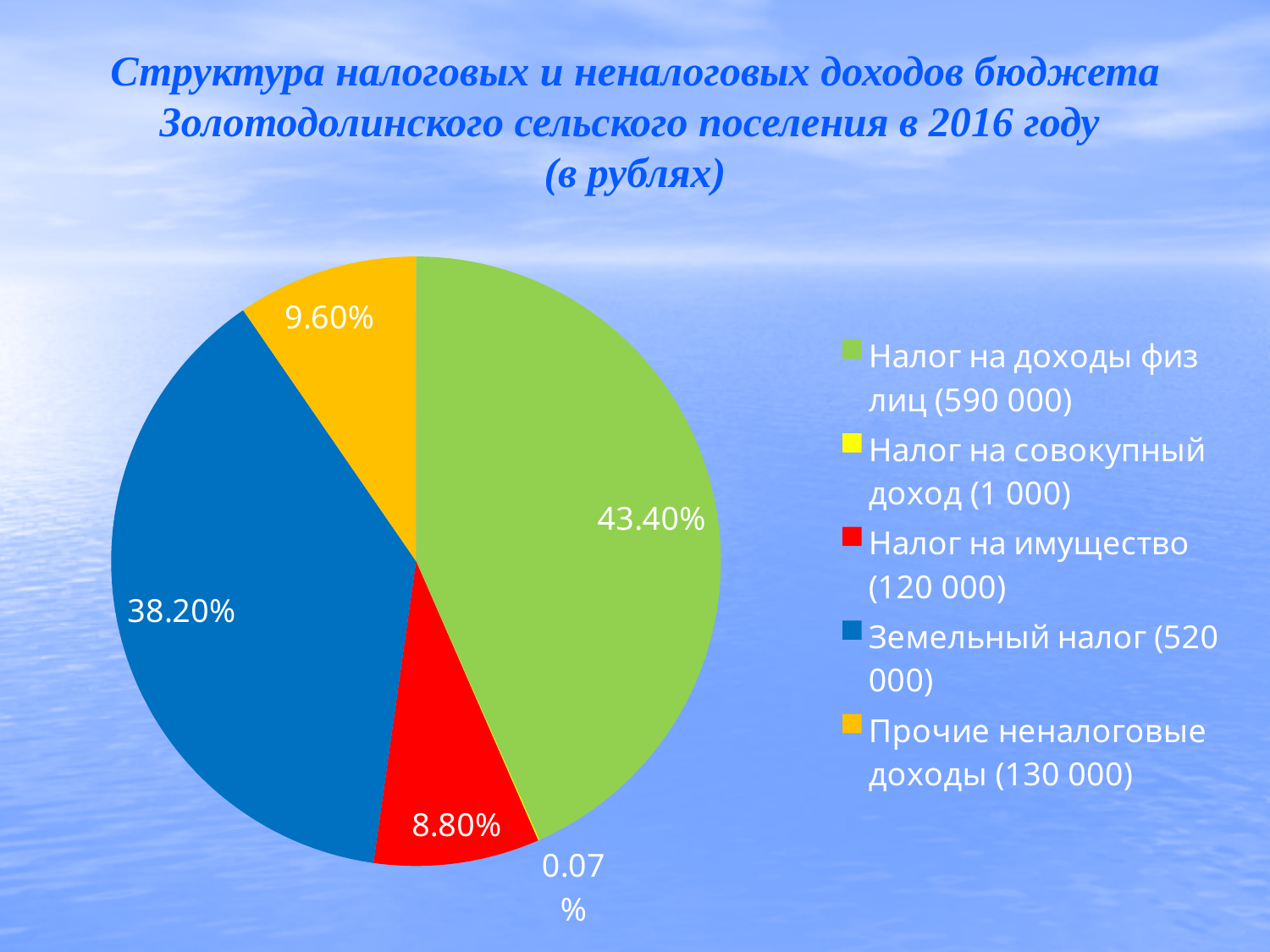
What is the difference in percentage points between the shares of Налог на доходы физ лиц and Земельный налог? 5.20 What percentage share is shown for Налог на доходы физ лиц? 43.40% What percentage share is shown for Прочие неналоговые доходы? 9.60% What percentage share is shown for Налог на имущество? 8.80% What kind of chart is shown on the slide? Pie chart Which category has the smallest share of the pie? Налог на совокупный доход Which category has the largest share of the pie? Налог на доходы физ лиц Which has a larger share: Прочие неналоговые доходы or Налог на имущество? Прочие неналоговые доходы What amount in roubles does the legend give for Земельный налог? 520 000 How many slices does the pie chart have? 5 What percentage share is shown for Земельный налог? 38.20% What percentage share is shown for Налог на совокупный доход? 0.07%